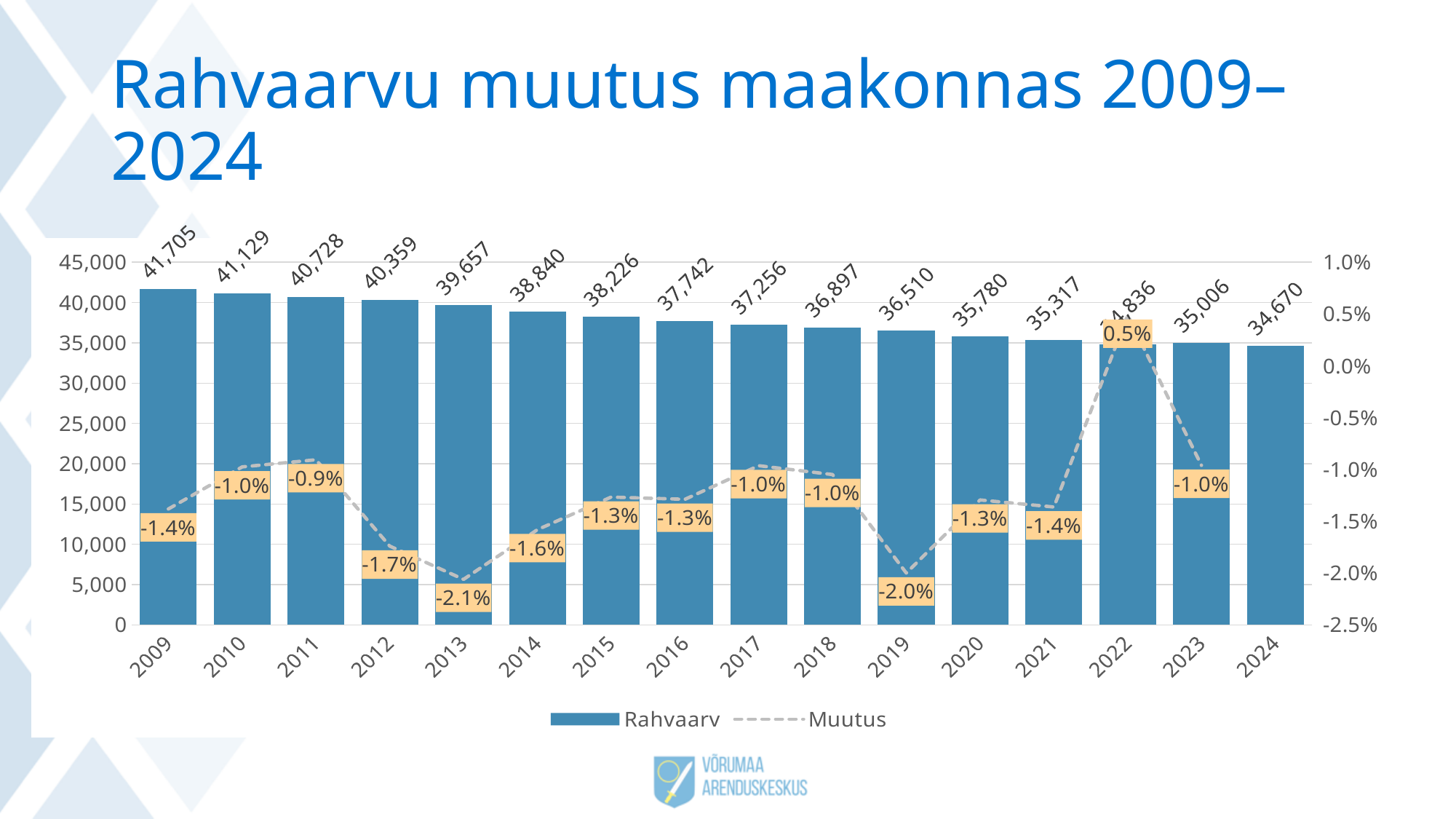
How many series does the legend list? 2 Which year has the lowest Muutus value? 2013 Do the Rahvaarv bars generally rise or fall from 2009 to 2024? fall What is the Muutus value for 2022? 0.5% Which year has the highest Rahvaarv value? 2009 What is the Rahvaarv value for 2024? 34,670 How many years are shown on the x axis? 16 What is the Muutus value for 2013? -2.1% What is the difference between the Rahvaarv values for 2009 and 2024? 7,035 Which is larger, the Rahvaarv value for 2022 or for 2023? 2023 What is the title of the chart? Rahvaarvu muutus maakonnas 2009–2024 What is the Rahvaarv value for 2009? 41,705